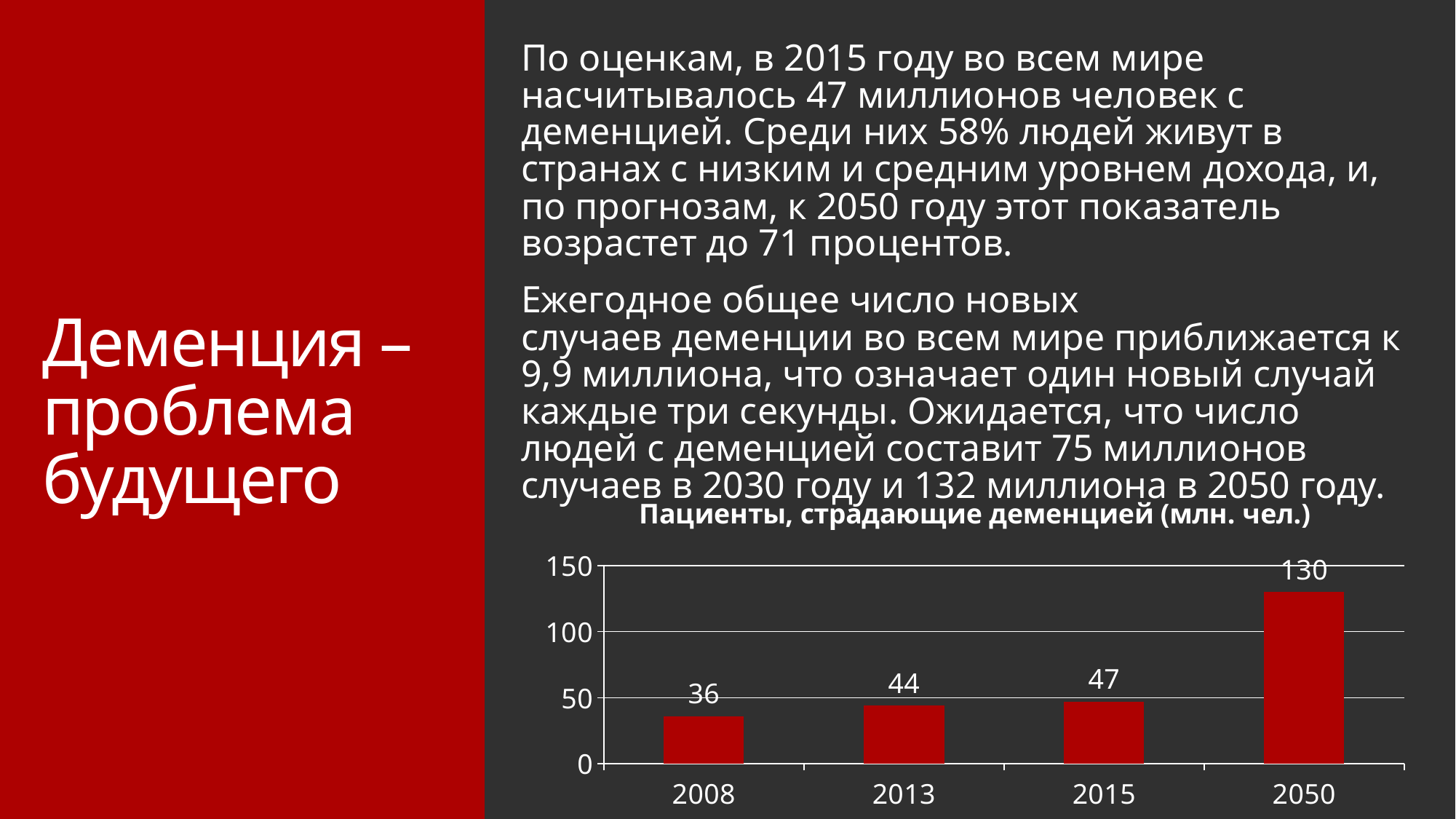
Which year has the lowest value in the chart? 2008 What is the value for 2015 in the chart? 47 How many years are shown on the x axis of the chart? 4 What is the value for 2050 in the chart? 130 What kind of chart is shown on the slide? bar chart What is the value for 2008 in the chart? 36 What is the title of the chart? Пациенты, страдающие деменцией (млн. чел.) What is the difference between the values for 2050 and 2015? 83 Which is larger, the value for 2013 or the value for 2015? 2015 Which year has the highest value in the chart? 2050 What is the value for 2013 in the chart? 44 What is the difference between the values for 2013 and 2008? 8